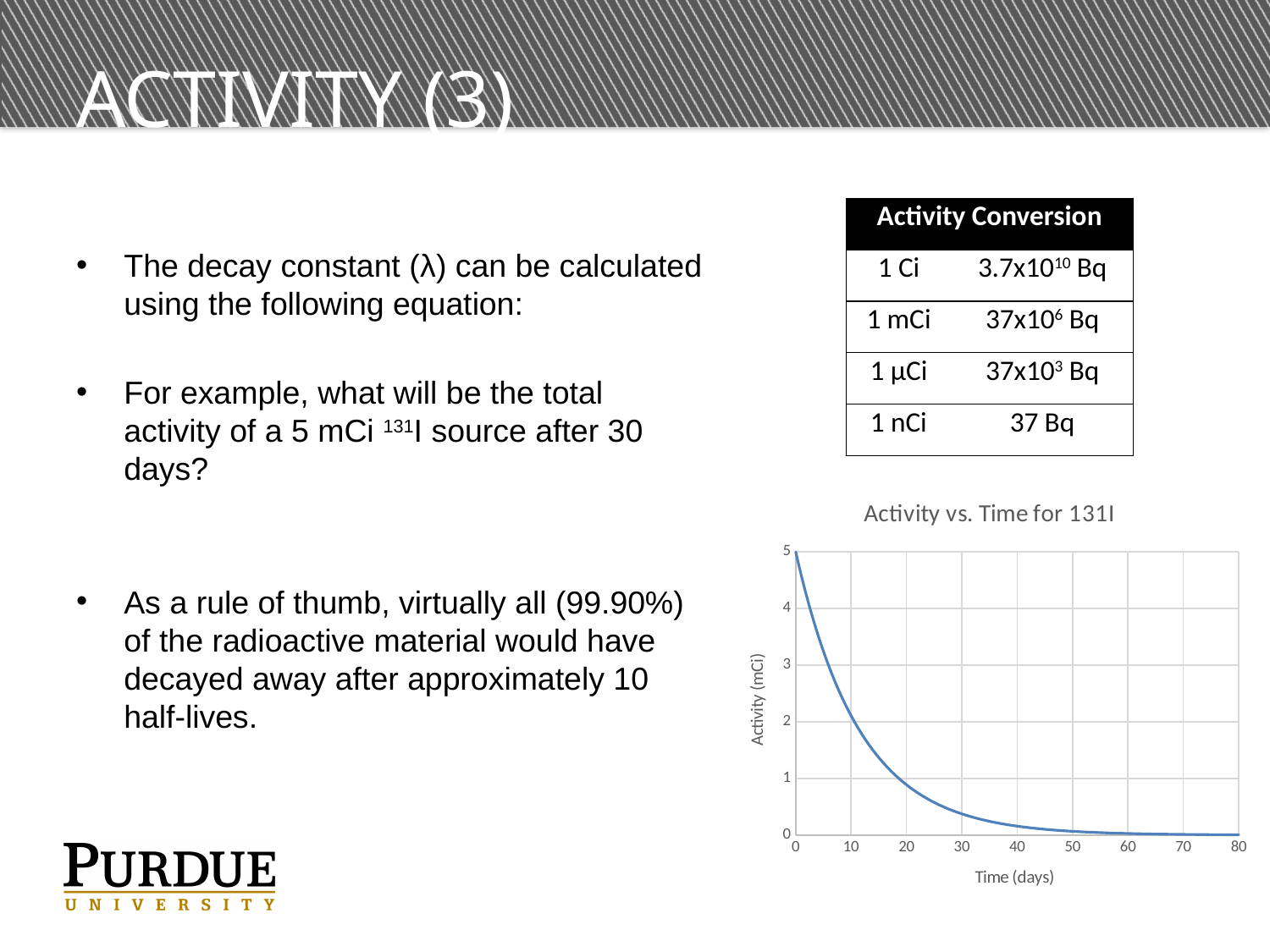
Is the activity at 5 days greater or less than 2 mCi? greater Which is larger, the activity at 10 days or the activity at 30 days? 10 days Is the activity at 30 days greater or less than 1 mCi? less At what time (days) is the activity highest on the chart? 0 Does the activity rise or fall as time increases along the x axis? fall Is the activity at 40 days greater or less than 1 mCi? less What kind of chart is shown on the slide? line chart What is the activity in mCi at time 0 days on the chart? 5 What is the title of the chart on the slide? Activity vs. Time for 131I What is the label of the y axis of the chart? Activity (mCi)